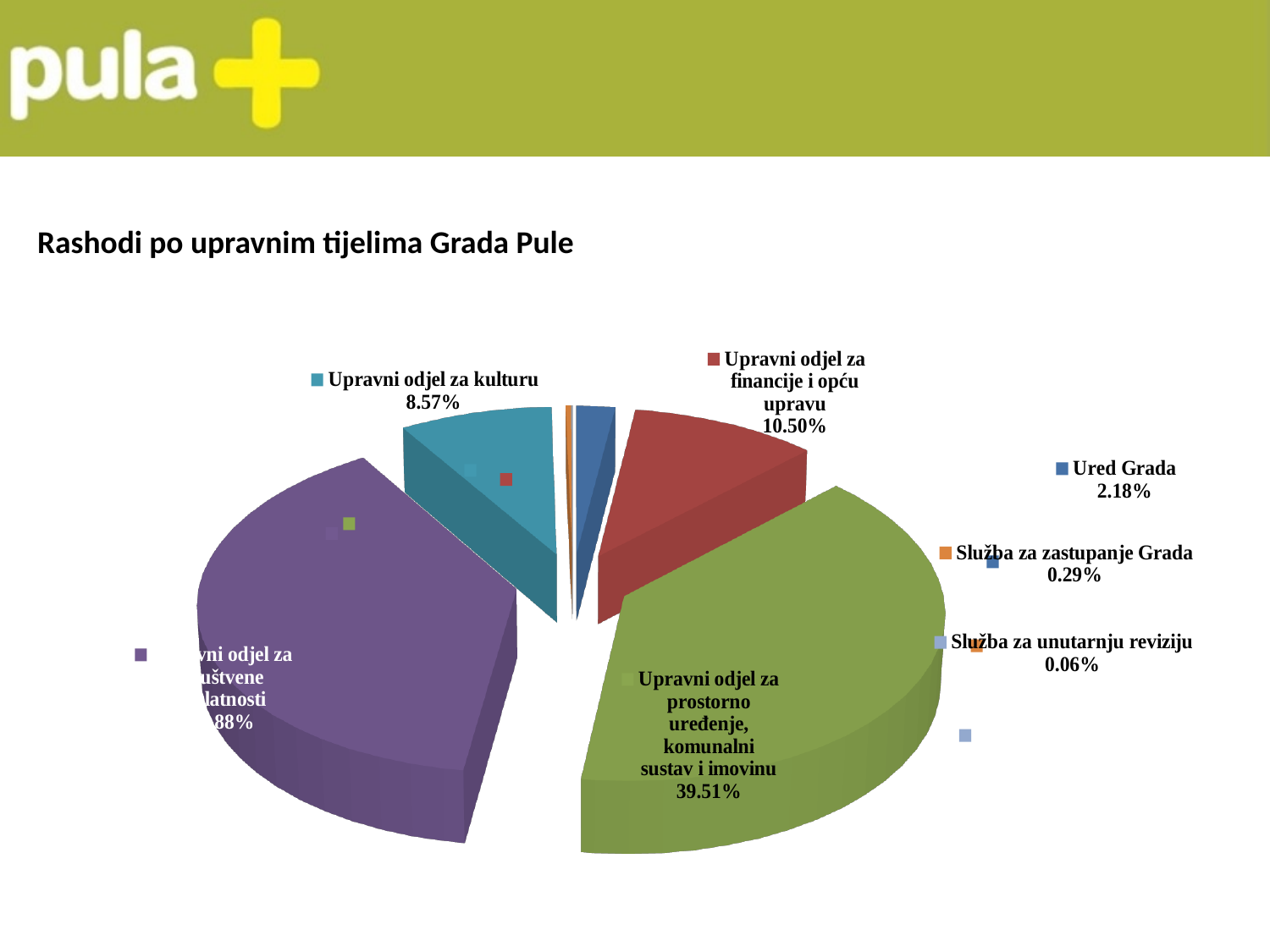
By how many percentage points does the share of Upravni odjel za prostorno uređenje, komunalni sustav i imovinu exceed that of Upravni odjel za financije i opću upravu? 29.01% What percentage is shown for Upravni odjel za financije i opću upravu? 10.50% What kind of chart is shown on the slide? Pie chart What share of the pie does Upravni odjel za kulturu have? 8.57% Which has the larger share: Ured Grada or Služba za zastupanje Grada? Ured Grada What is the title of the chart on the slide? Rashodi po upravnim tijelima Grada Pule How many slices does the pie chart have? 7 What is the difference between the shares of Upravni odjel za financije i opću upravu and Upravni odjel za kulturu? 1.93% What percentage is labelled for Služba za zastupanje Grada? 0.29% What is the value shown for Ured Grada? 2.18% Which category has the smallest share of the pie? Služba za unutarnju reviziju What share is shown for Upravni odjel za prostorno uređenje, komunalni sustav i imovinu? 39.51%